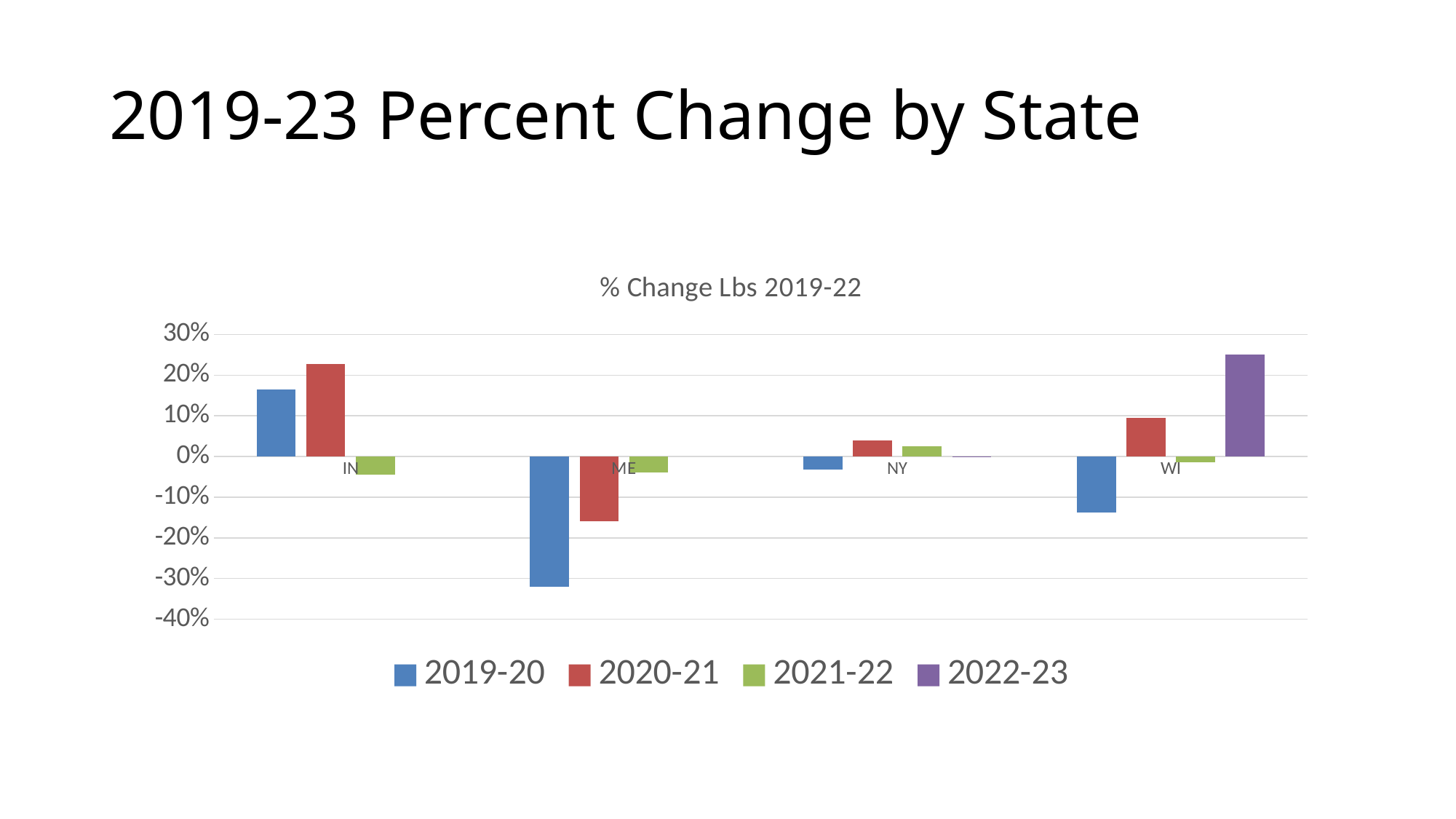
Is the 2022-23 value for WI greater or less than 20%? greater Which state has the lowest 2019-20 value? ME Which series is shown in purple in the legend? 2022-23 What kind of chart is shown on the slide? bar chart Which state has the highest 2020-21 value? IN Is the 2020-21 value for IN greater or less than 20%? greater How many states (categories) are shown on the x axis of the chart? 4 Is the 2019-20 value for WI greater or less than -10%? less What is the title of the chart? % Change Lbs 2019-22 Which is larger, the 2020-21 value for WI or the 2020-21 value for NY? WI How many series does the chart's legend list? 4